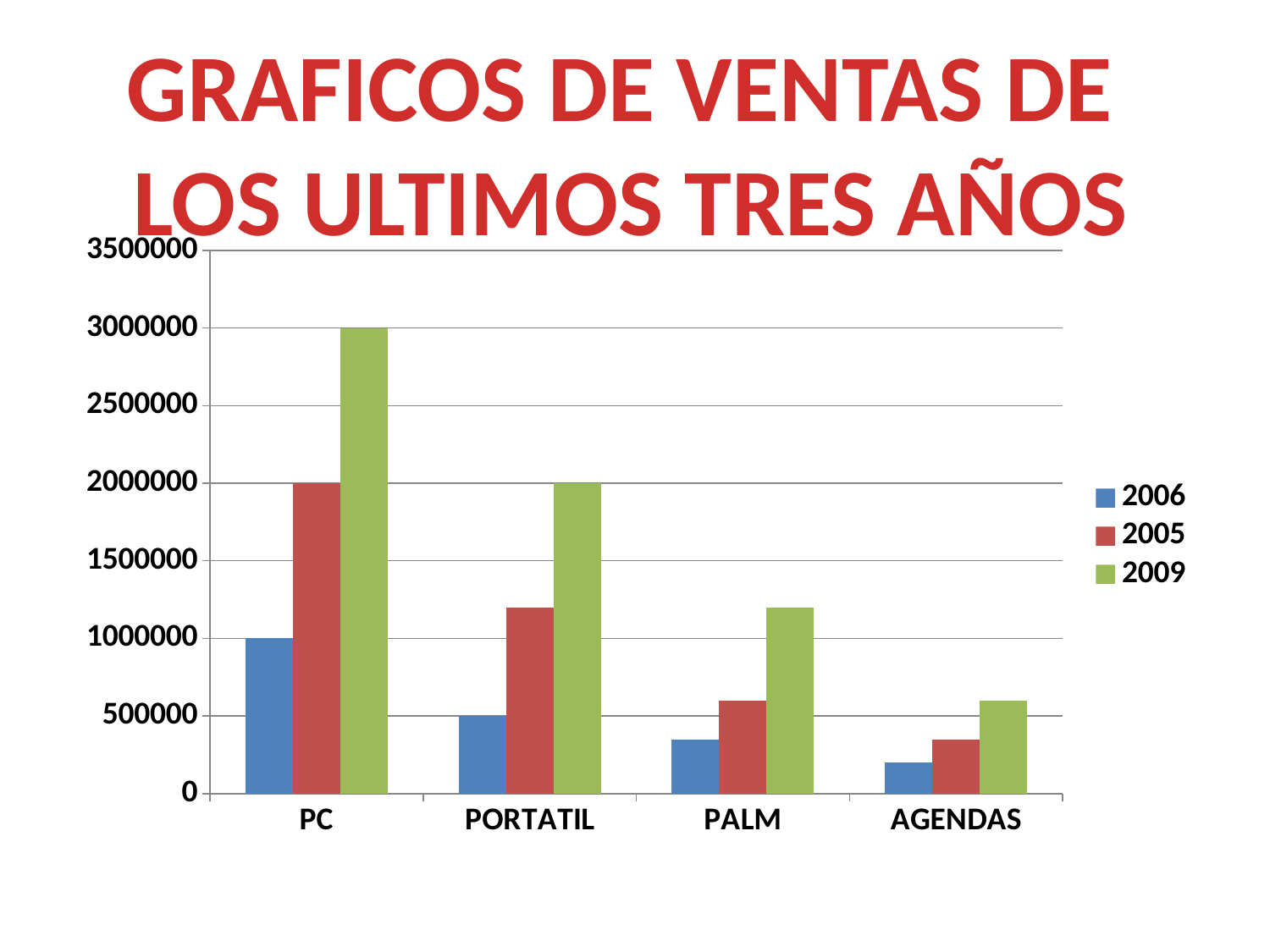
What is the value for PC in the 2005 series? 2000000 Which category has the highest value in the 2009 series? PC Which category has the lowest value in the 2006 series? AGENDAS Is the value for PALM in the 2009 series greater or less than 1000000? greater How many categories are shown on the x axis? 4 What kind of chart is shown on the slide? bar chart What is the value for PC in the 2006 series? 1000000 Which is larger for PORTATIL: the 2005 value or the 2009 value? 2009 What is the difference between the 2009 and 2006 values for PC? 2000000 What is the value for PORTATIL in the 2009 series? 2000000 How many series does the legend list? 3 What is the value for PC in the 2009 series? 3000000